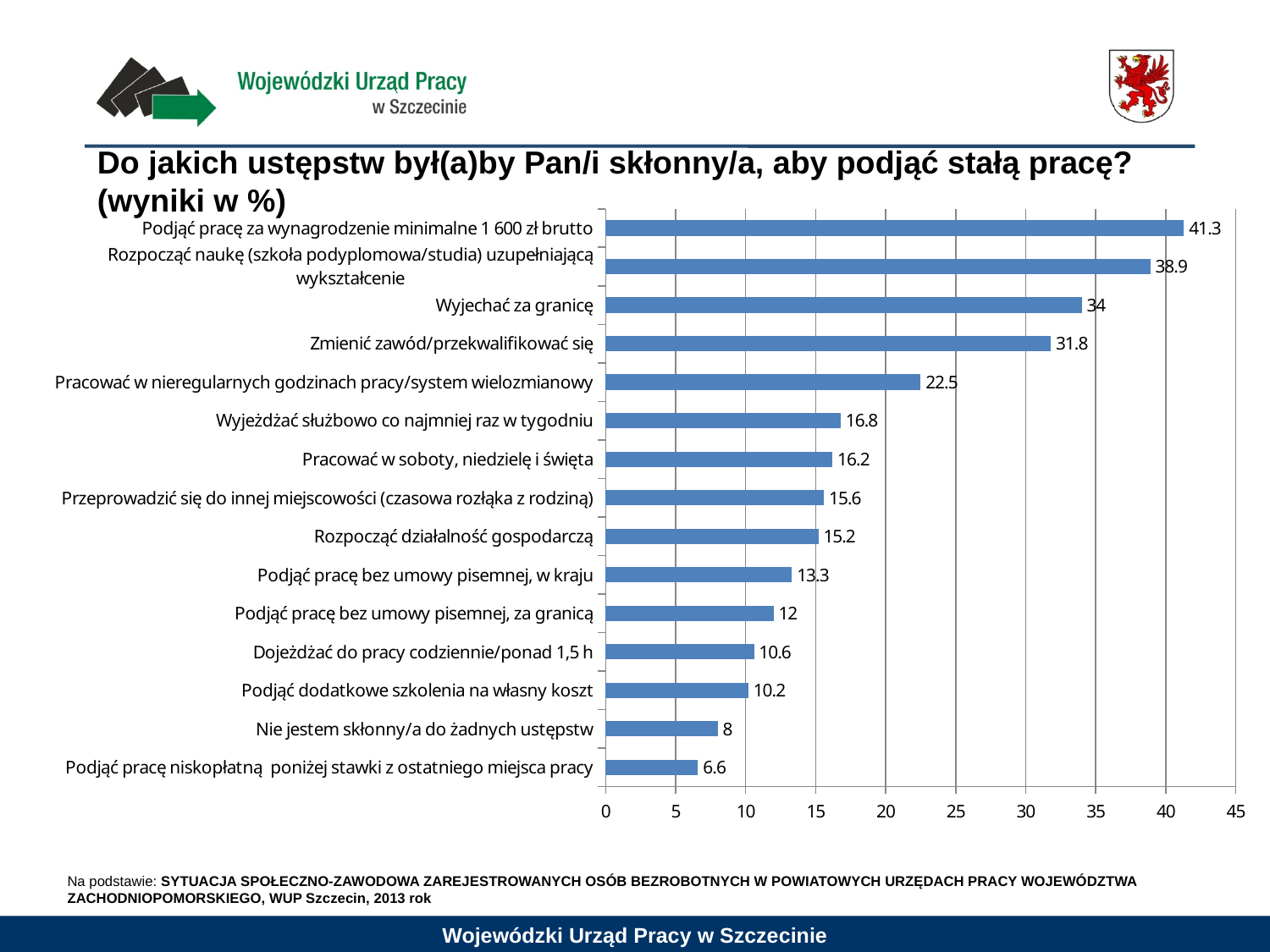
What is the value for "Zmienić zawód/przekwalifikować się"? 31.8 Is the value for "Pracować w nieregularnych godzinach pracy/system wielozmianowy" greater or less than 20? greater What kind of chart is shown on the slide? bar chart What is the difference between the values for "Podjąć pracę za wynagrodzenie minimalne 1 600 zł brutto" and "Rozpocząć naukę (szkoła podyplomowa/studia) uzupełniającą wykształcenie"? 2.4 What is the maximum value shown on the horizontal axis? 45 What is the difference between the values for "Dojeżdżać do pracy codziennie/ponad 1,5 h" and "Podjąć dodatkowe szkolenia na własny koszt"? 0.4 What is the value for "Nie jestem skłonny/a do żadnych ustępstw"? 8 Which category has the lowest value? Podjąć pracę niskopłatną poniżej stawki z ostatniego miejsca pracy How many categories are shown in the chart? 15 Which category has the highest value? Podjąć pracę za wynagrodzenie minimalne 1 600 zł brutto What is the value for "Wyjechać za granicę"? 34 Which is larger: the value for "Pracować w soboty, niedzielę i święta" or the value for "Podjąć pracę bez umowy pisemnej, w kraju"? Pracować w soboty, niedzielę i święta